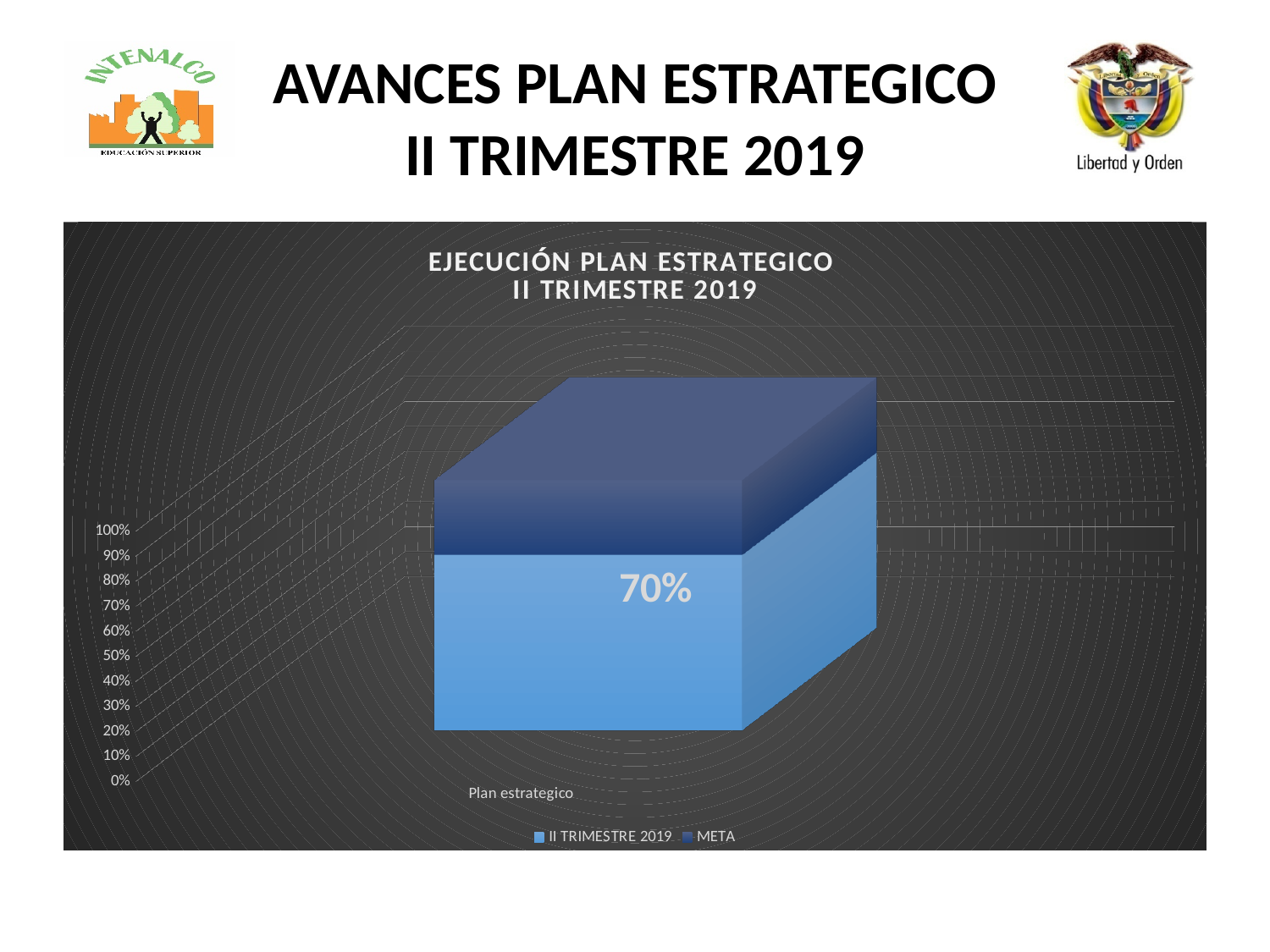
What is the value for II TRIMESTRE 2019 for Plan estrategico? 70% Is the value for II TRIMESTRE 2019 greater or less than 50%? greater What is the title of the chart? EJECUCIÓN PLAN ESTRATEGICO II TRIMESTRE 2019 How many categories are shown on the x axis of the chart? 1 How many series does the chart legend list? 2 What is the name of the category shown on the x axis? Plan estrategico What are the two series listed in the chart legend? II TRIMESTRE 2019 and META What is the highest value shown on the chart's vertical axis? 100% What kind of chart is shown on the slide? Bar chart